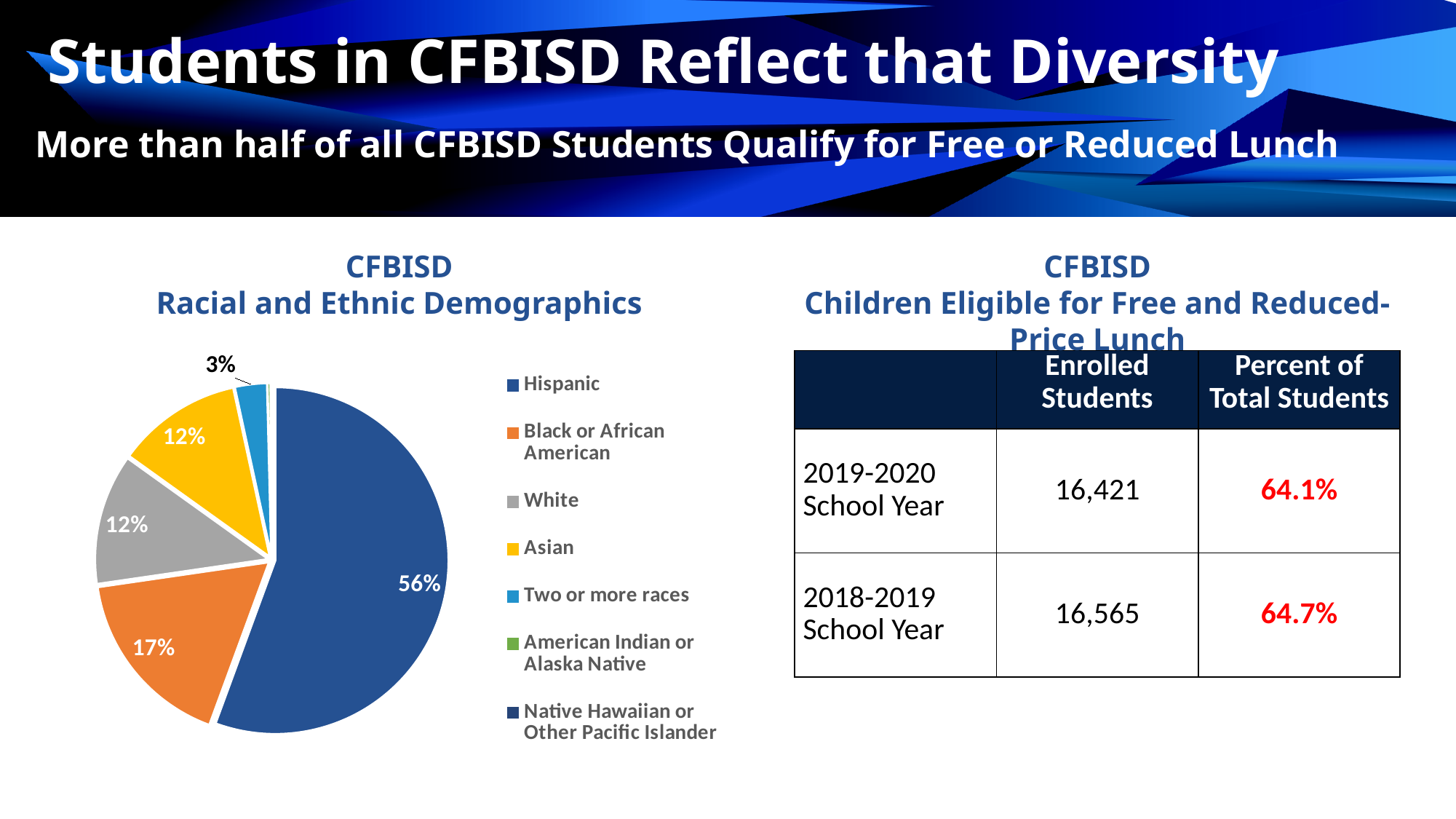
In the CFBISD Racial and Ethnic Demographics pie chart, what percentage is shown for Asian? 12% In the CFBISD Racial and Ethnic Demographics pie chart, which is larger, the Black or African American slice or the Asian slice? Black or African American In the CFBISD Racial and Ethnic Demographics pie chart, what percentage is shown for Two or more races? 3% In the CFBISD Racial and Ethnic Demographics pie chart, what is the difference in percentage points between the Hispanic and Black or African American slices? 39 percentage points In the CFBISD Racial and Ethnic Demographics pie chart, what percentage is shown for Black or African American? 17% What type of chart is the CFBISD Racial and Ethnic Demographics chart? Pie chart How many categories does the legend of the CFBISD Racial and Ethnic Demographics chart list? 7 In the CFBISD Racial and Ethnic Demographics pie chart, what percentage is shown for White? 12% In the CFBISD Racial and Ethnic Demographics pie chart, which category has the largest slice? Hispanic In the CFBISD Racial and Ethnic Demographics pie chart, what percentage is shown for Hispanic? 56% In the CFBISD Racial and Ethnic Demographics pie chart, what colour is the Asian slice? Yellow In the CFBISD Racial and Ethnic Demographics pie chart, which is larger, the Hispanic slice or the Black or African American slice? Hispanic